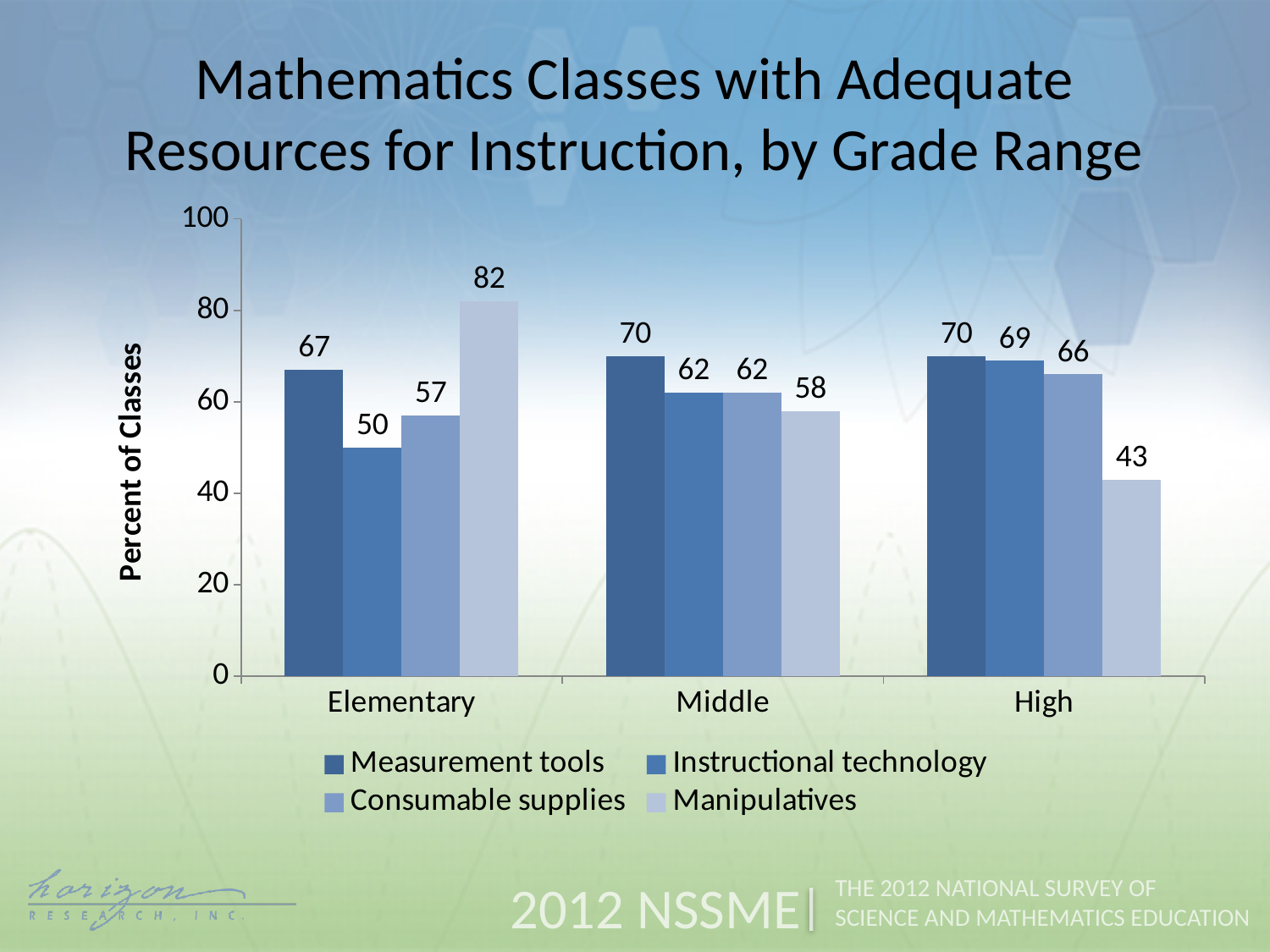
Which grade range has the lowest value for Manipulatives? High What is the label of the y axis? Percent of Classes What is the difference between the Manipulatives values for Elementary and High? 39 What kind of chart is shown on the slide? Bar chart Which is larger: Measurement tools for Elementary or Measurement tools for Middle? Measurement tools for Middle How many series does the legend list? 4 Which resource has the highest value in the Elementary grade range? Manipulatives What is the value for Instructional technology in the Elementary grade range? 50 What is the value for Consumable supplies in the High grade range? 66 How many grade ranges are shown on the x axis? 3 Is the value for Manipulatives in the High grade range greater or less than 60? less What percent of elementary mathematics classes have adequate manipulatives? 82